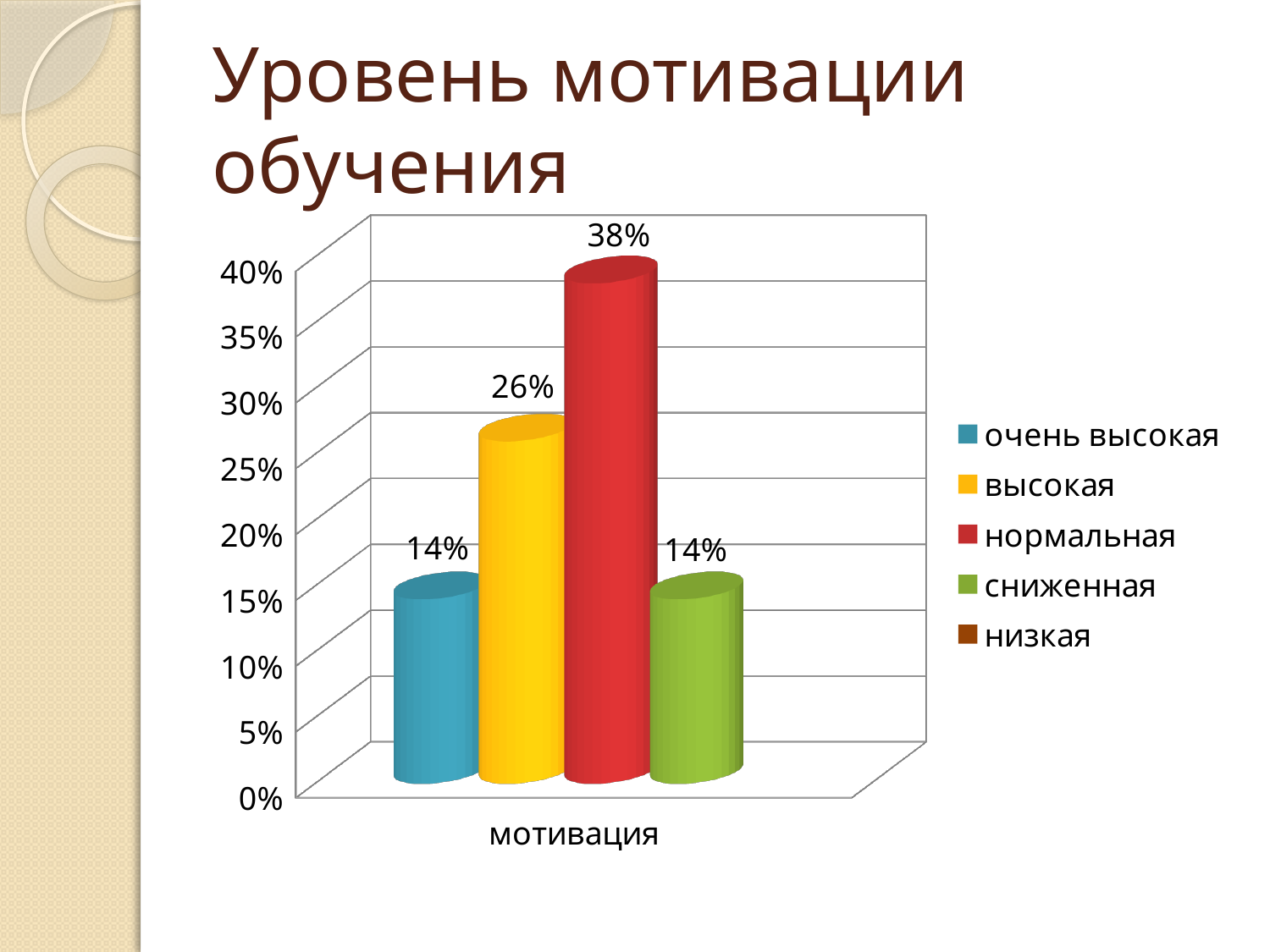
Which series has the highest value? нормальная What is the value for the series "сниженная"? 14% Is the value for "нормальная" greater or less than 35%? greater Which is larger, the value for "высокая" or the value for "сниженная"? высокая What is the difference between the values for "нормальная" and "высокая"? 12% What is the title of the slide containing the chart? Уровень мотивации обучения How many series does the legend list? 5 What is the value for the series "высокая"? 26% What is the value for the series "нормальная"? 38% What is the difference between the values for "высокая" and "очень высокая"? 12% What is the value for the series "очень высокая"? 14% What kind of chart is shown on the slide? bar chart